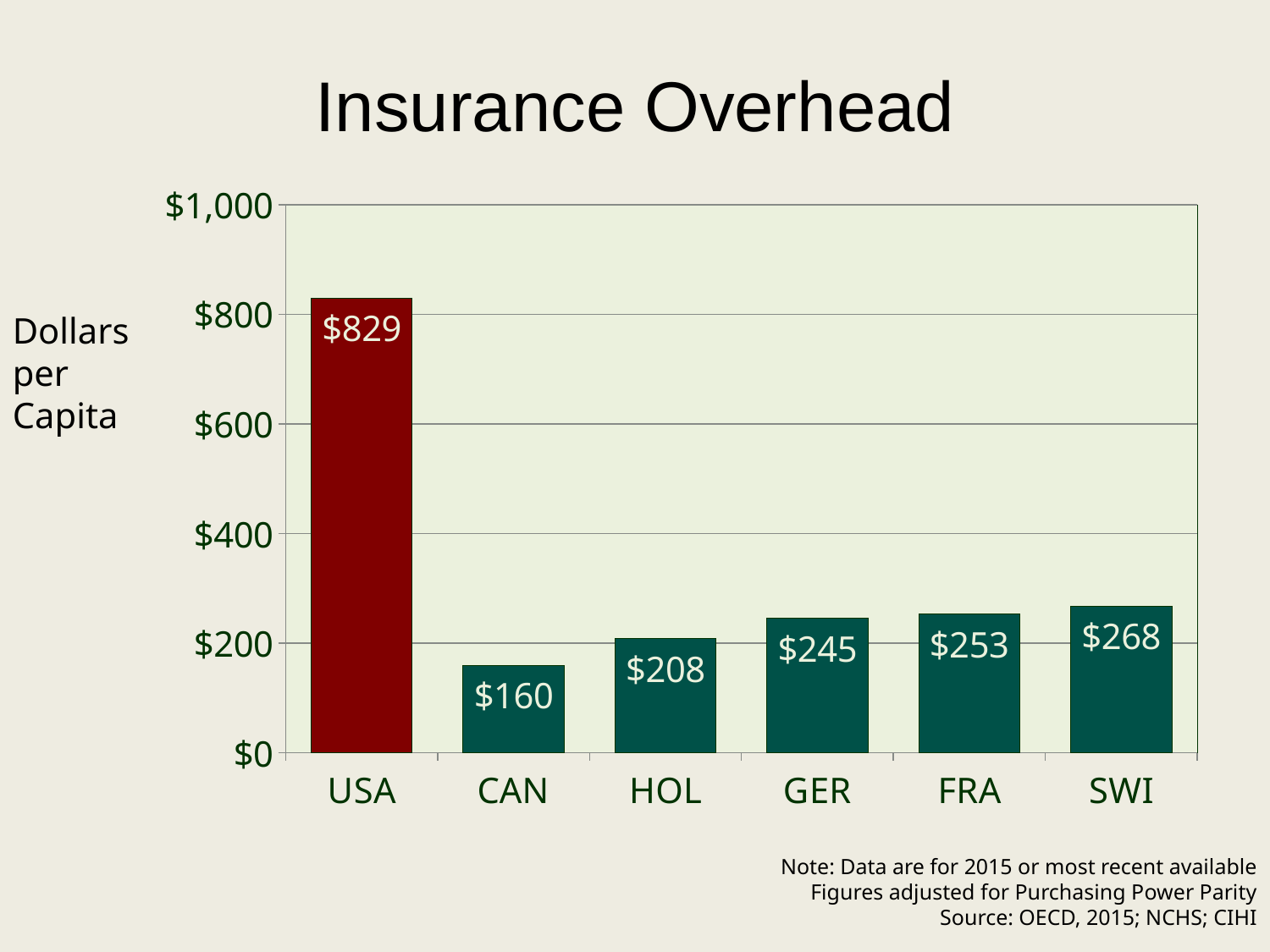
Is the value for HOL greater or less than $400? less How many countries are shown on the chart? 6 Which country has the highest insurance overhead per capita? USA What is the insurance overhead per capita for the USA? $829 Which is larger, the value for SWI or the value for GER? SWI What kind of chart is shown on the slide? Bar chart What is the title of the chart? Insurance Overhead What is the difference between the FRA value and the HOL value? $45 What is the value shown for GER? $245 What is the value shown for CAN? $160 Which country has the lowest insurance overhead per capita? CAN What is the difference between the USA value and the SWI value? $561